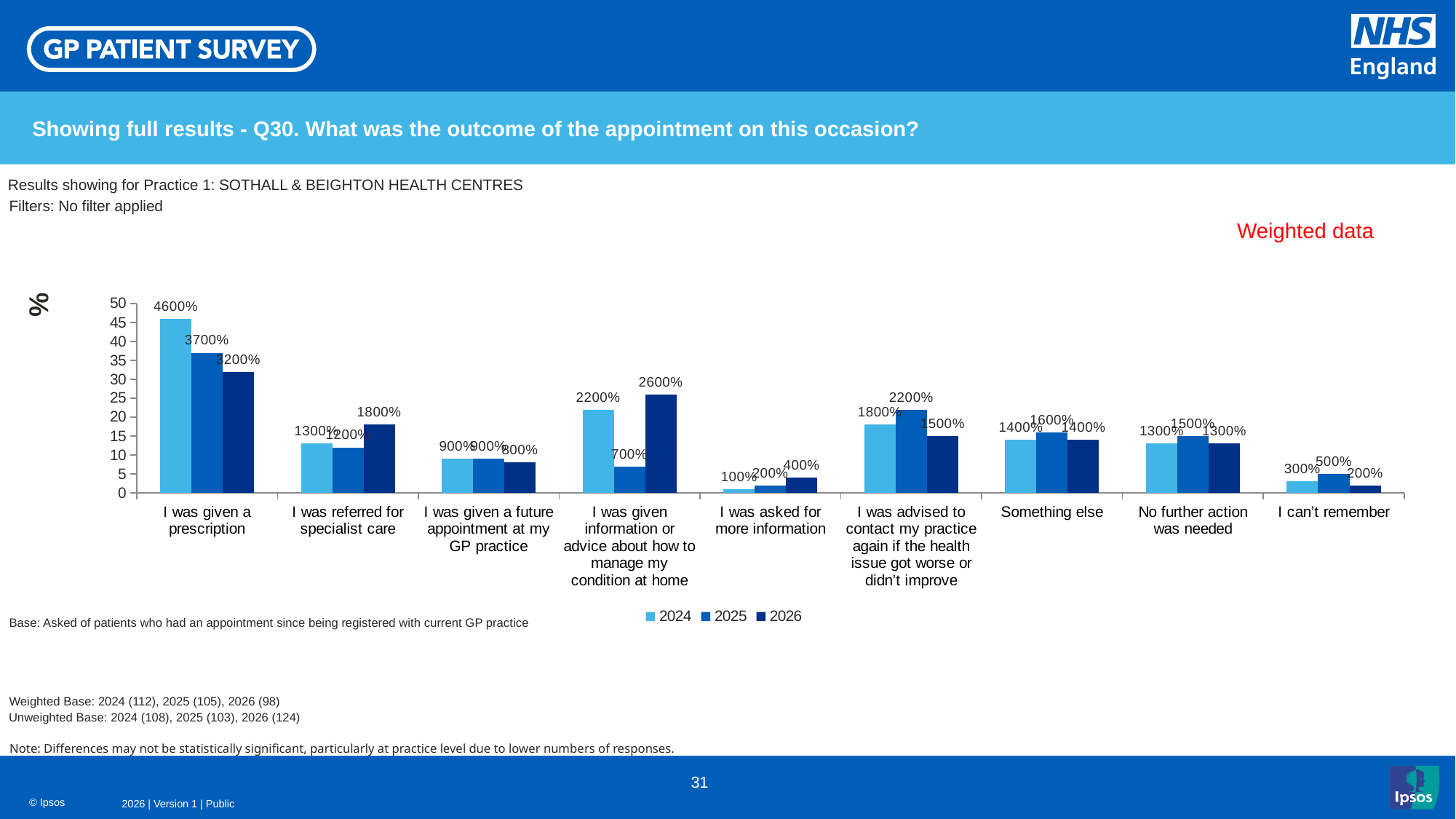
What type of chart is shown on the slide? bar chart What is the data label for 2026 for 'I was given information or advice about how to manage my condition at home'? 2600% Which category has the lowest value for 2024? I was asked for more information How many outcome categories are shown on the x axis? 9 What is the data label for 2025 for 'I was advised to contact my practice again if the health issue got worse or didn't improve'? 2200% What is the difference between the 2024 and 2026 data labels for 'I was given a prescription'? 1400% Which category has the highest value for 2024? I was given a prescription What is the data label for 2024 for 'I was given a prescription'? 4600% What is the data label for 2026 for 'I can't remember'? 200% How many series does the legend list? 3 Which is larger for 'I was referred for specialist care': the 2025 value or the 2026 value? 2026 Do the values for 'I was given a prescription' rise or fall from 2024 to 2026? fall